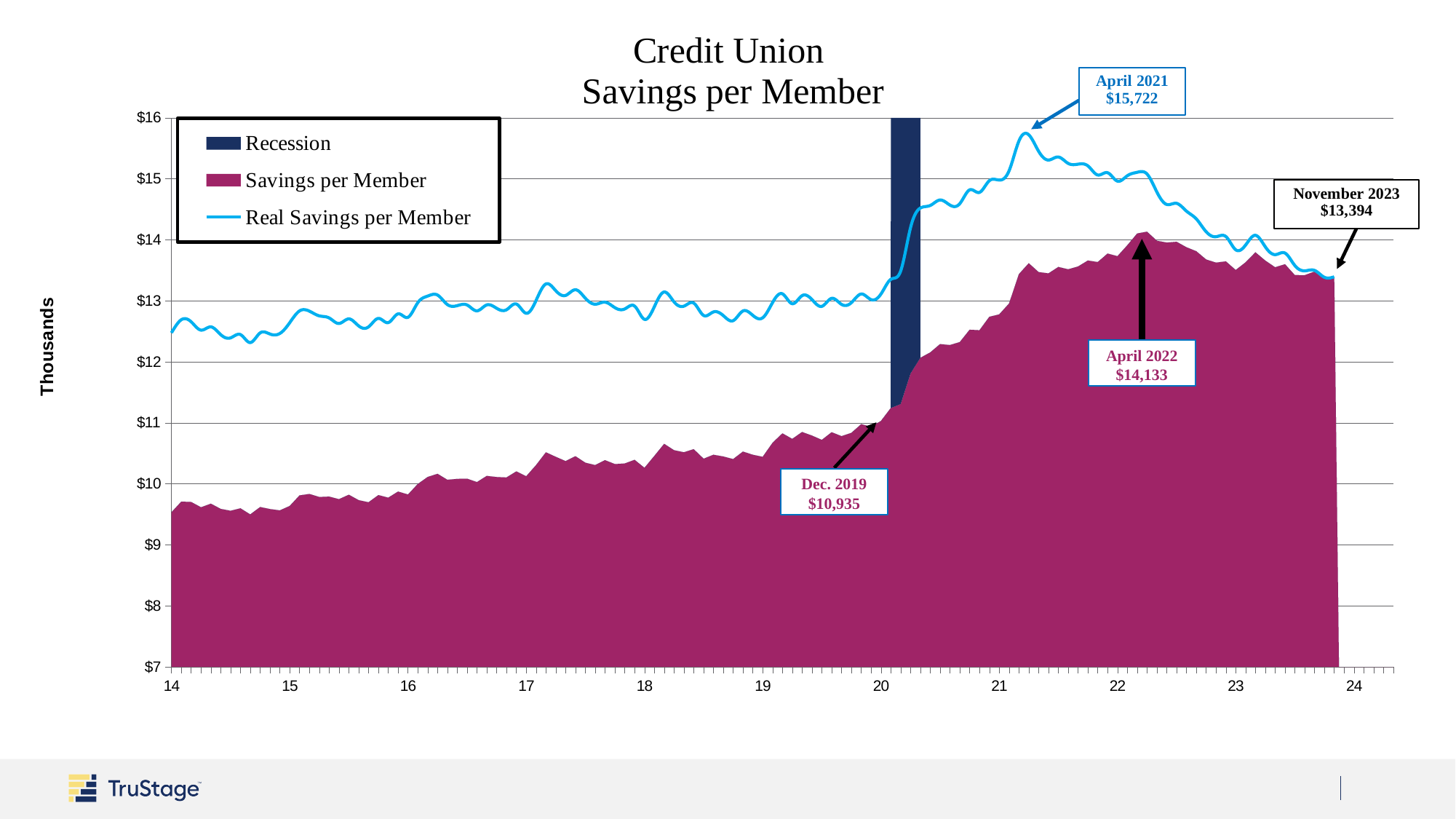
Which annotated value is larger: April 2022 or Dec. 2019? April 2022 Is the Real Savings per Member value at the start of 2016 greater or less than $12? greater What value is annotated for November 2023? $13,394 How many entries does the legend list? 3 What was Savings per Member in Dec. 2019, according to the annotation? $10,935 What value is annotated for April 2021 on the Real Savings per Member line? $15,722 Does Savings per Member rise or fall from 2014 to 2022? rise What is the difference between the annotated April 2022 value and the annotated Dec. 2019 value? $3,198 What unit label is shown on the vertical axis? Thousands What is the difference between the annotated April 2021 value and the annotated November 2023 value? $2,328 What value is annotated for April 2022 on the Savings per Member series? $14,133 Is the Savings per Member value at the start of 2014 greater or less than $10? less